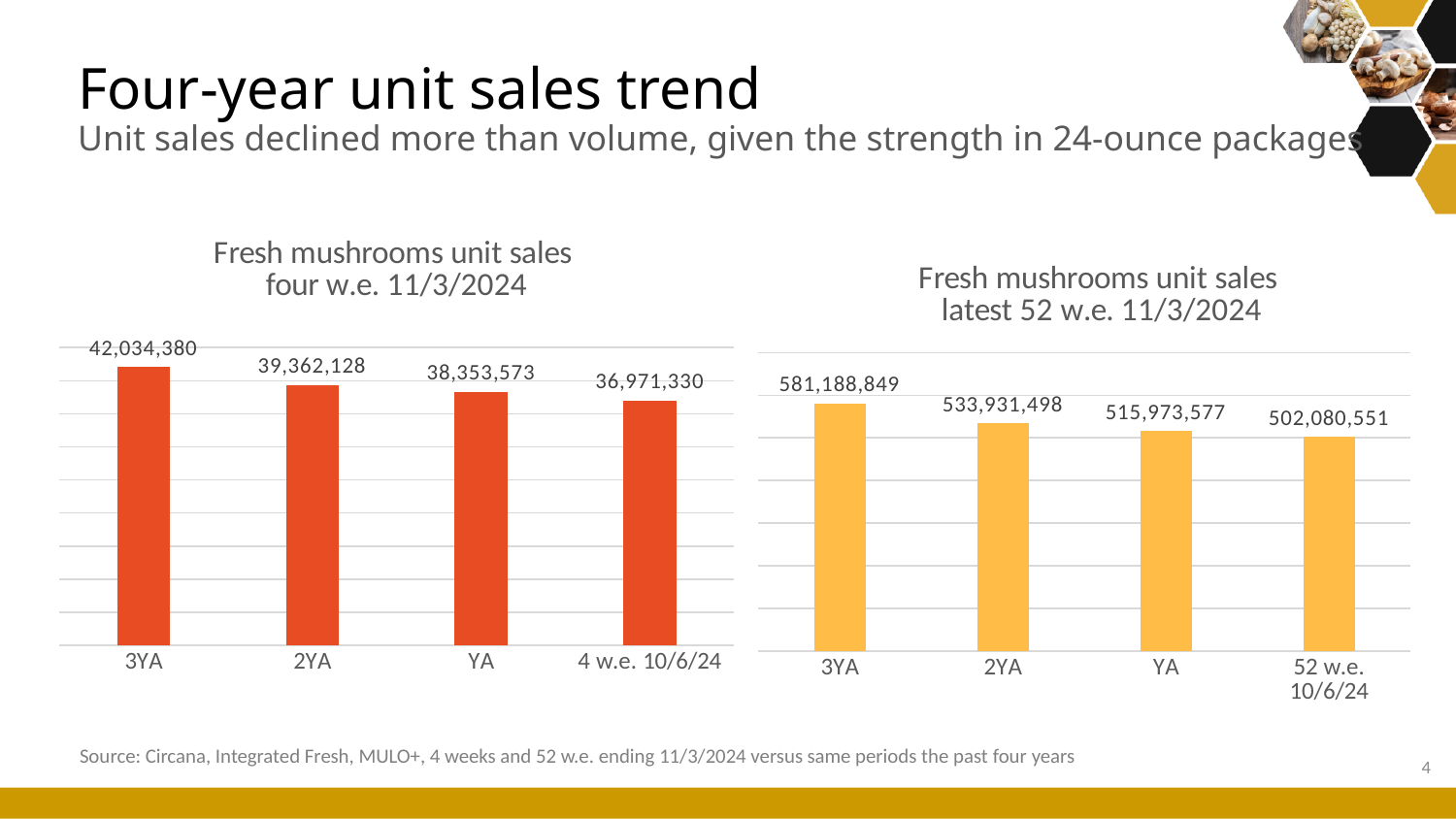
In the 'Fresh mushrooms unit sales latest 52 w.e. 11/3/2024' chart, which period has the lowest value? 52 w.e. 10/6/24 In the 'Fresh mushrooms unit sales four w.e. 11/3/2024' chart, what is the value for 4 w.e. 10/6/24? 36,971,330 In the 'Fresh mushrooms unit sales four w.e. 11/3/2024' chart, what is the difference between the 3YA value and the 4 w.e. 10/6/24 value? 5,063,050 In the 'Fresh mushrooms unit sales four w.e. 11/3/2024' chart, what is the value for 3YA? 42,034,380 In the 'Fresh mushrooms unit sales latest 52 w.e. 11/3/2024' chart, what is the value for 2YA? 533,931,498 In the 'Fresh mushrooms unit sales latest 52 w.e. 11/3/2024' chart, which is larger, the value for YA or the value for 52 w.e. 10/6/24? YA In the 'Fresh mushrooms unit sales four w.e. 11/3/2024' chart, do the values rise or fall from 3YA to 4 w.e. 10/6/24? Fall What kind of chart is the 'Fresh mushrooms unit sales latest 52 w.e. 11/3/2024' chart? Bar chart How many bars are in the 'Fresh mushrooms unit sales four w.e. 11/3/2024' chart? 4 In the 'Fresh mushrooms unit sales latest 52 w.e. 11/3/2024' chart, what is the value for 52 w.e. 10/6/24? 502,080,551 In the 'Fresh mushrooms unit sales four w.e. 11/3/2024' chart, which period has the highest value? 3YA In the 'Fresh mushrooms unit sales latest 52 w.e. 11/3/2024' chart, what is the difference between the 3YA value and the 2YA value? 47,257,351